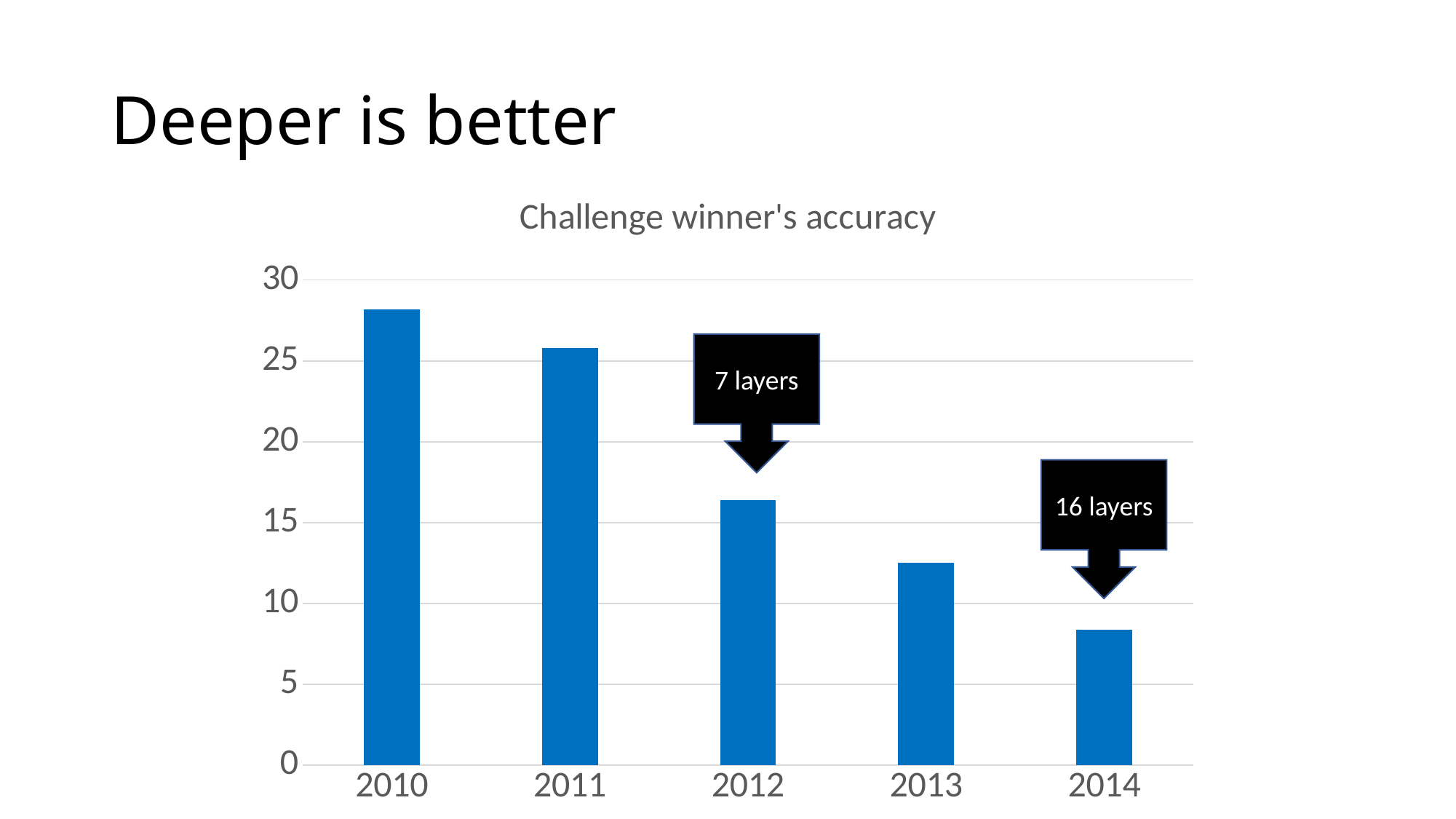
Is the value for 2013 greater or less than 10? greater How many years are shown on the x axis of the chart? 5 Is the value for 2014 greater or less than 10? less Is the value for 2010 greater or less than 25? greater Do the values rise or fall from 2010 to 2014? fall What is the title of the chart? Challenge winner's accuracy Which year has the highest bar in the chart? 2010 Which is larger, the value for 2011 or the value for 2013? 2011 Which year has the lowest bar in the chart? 2014 What kind of chart is shown on the slide? bar chart What does the callout pointing at the 2014 bar say? 16 layers